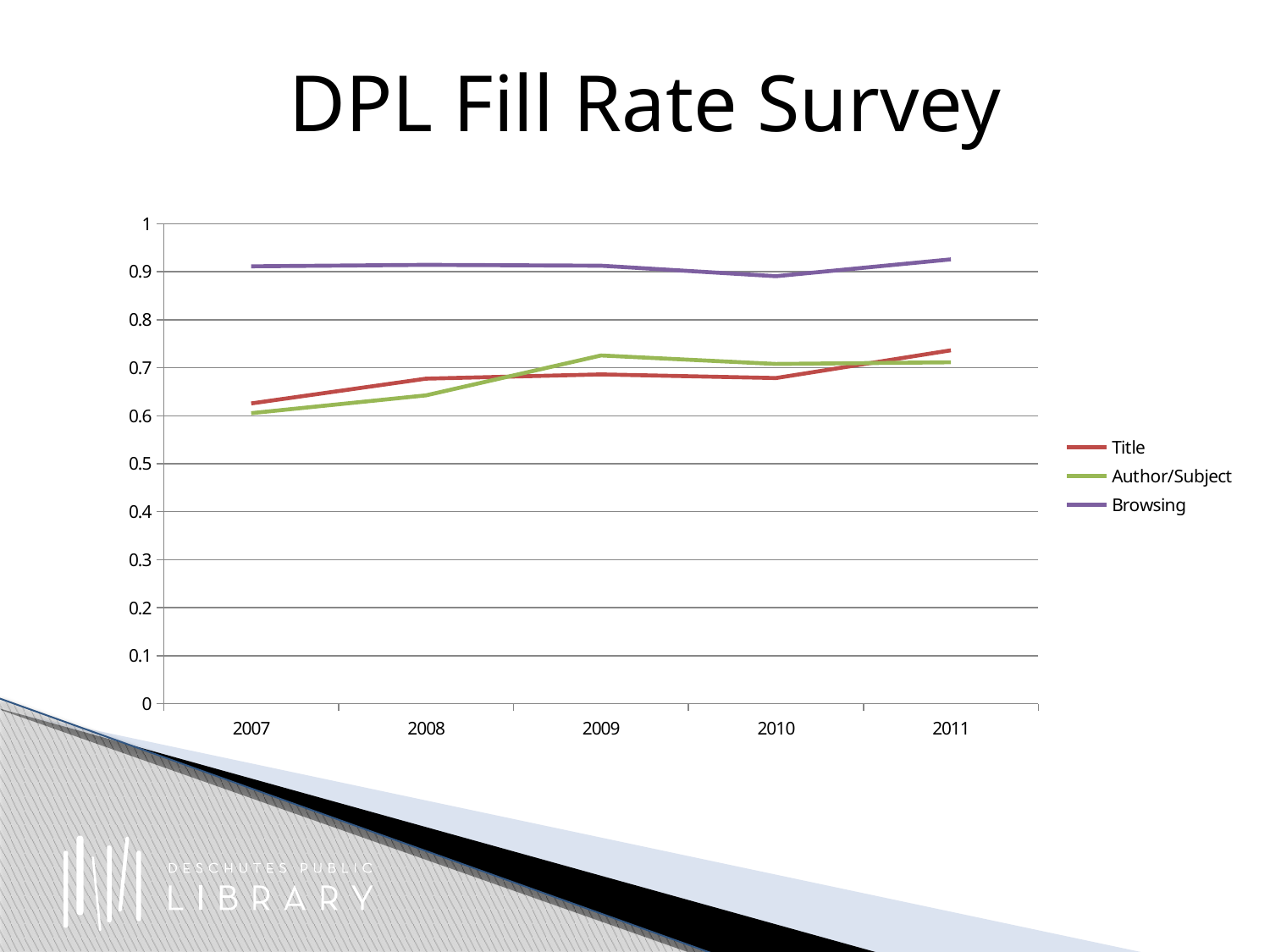
What colour is the Browsing line in the legend? purple How many years are shown on the x axis? 5 Which series has the lowest value in 2007? Author/Subject In 2011, which is higher, Title or Author/Subject? Title Is the value for Browsing in 2007 greater or less than 0.8? greater Is the value for Author/Subject in 2009 greater or less than 0.7? greater Is the value for Title in 2007 greater or less than 0.7? less Does the Title series rise or fall from 2007 to 2011? rise Which series has the highest fill rate across all years? Browsing What kind of chart is shown on the slide? line chart How many series does the legend list? 3